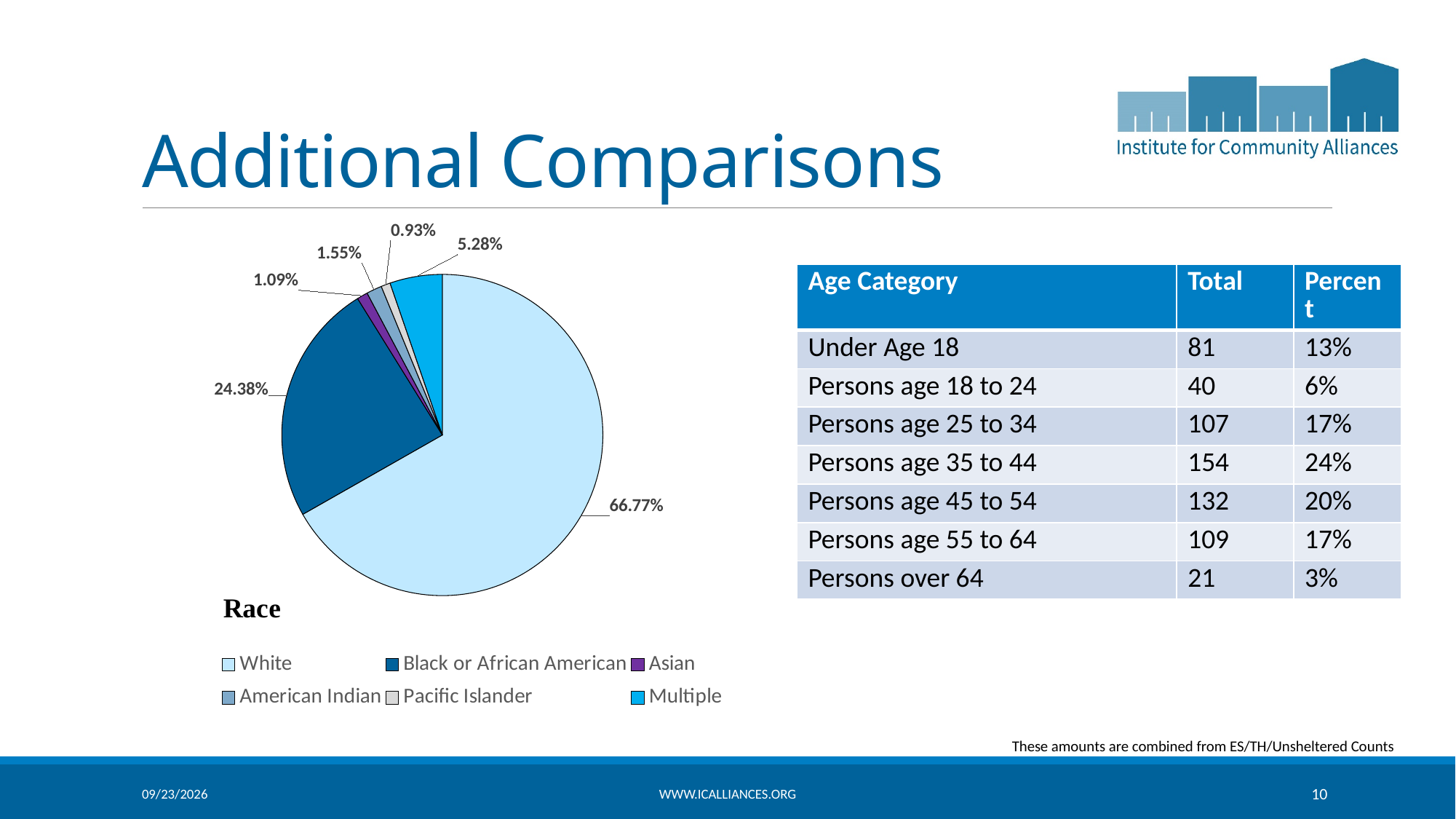
What share of the pie does Pacific Islander represent? 0.93% What is the difference in percentage points between the White and Black or African American slices? 42.39 Which slice is larger, American Indian or Multiple? Multiple What type of chart is shown on the slide? pie chart Which category has the largest slice of the pie? White How many categories does the pie chart's legend list? 6 What share of the pie does Multiple represent? 5.28% What is the title of the chart? Race Which category has the smallest slice of the pie? Pacific Islander What share of the pie does Asian represent? 1.09%